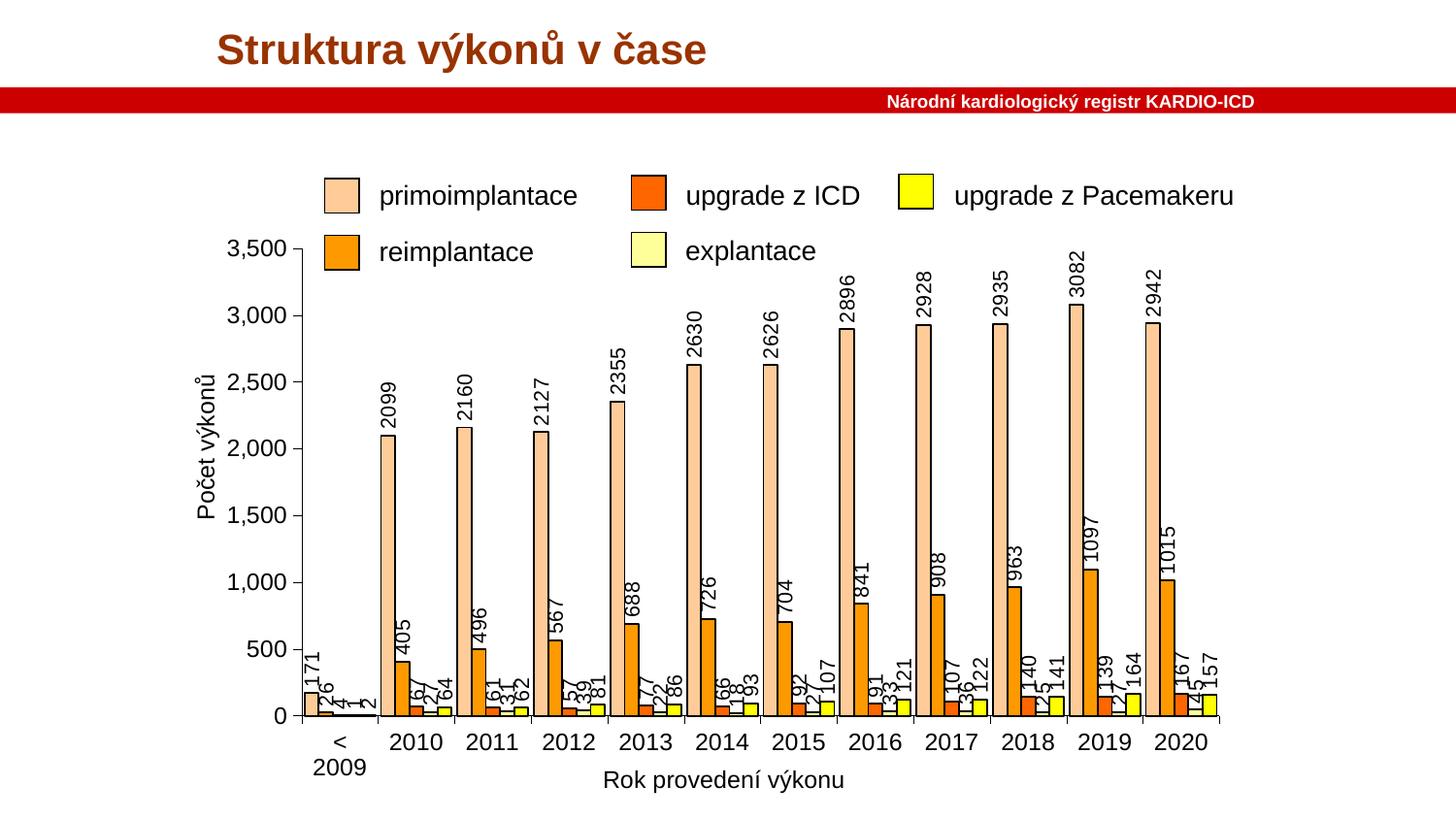
In which year is the primoimplantace value highest? 2019 In which category is the primoimplantace value lowest? < 2009 What kind of chart is shown on the slide? bar chart What is the value for primoimplantace in 2019? 3082 Which year has the larger reimplantace value, 2018 or 2019? 2019 What is the title of the y axis? Počet výkonů How many year categories are shown on the x axis? 12 Is the primoimplantace value for 2013 greater or less than 2,000? greater What is the difference between the primoimplantace values for 2019 and 2020? 140 What is the value for reimplantace in 2020? 1015 Do the primoimplantace values generally rise or fall from 2010 to 2019? rise How many series does the legend list? 5